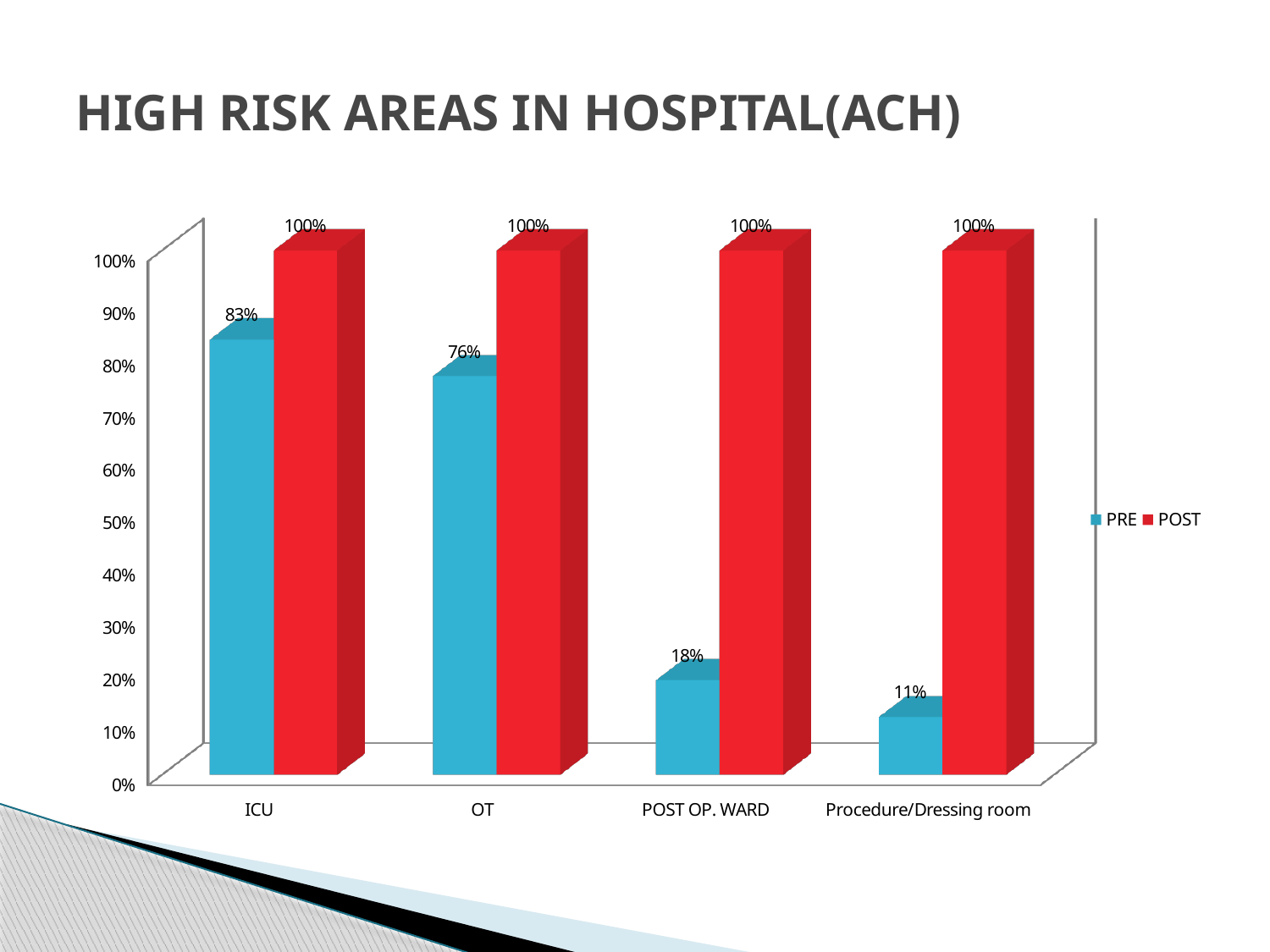
What is the PRE value for Procedure/Dressing room? 11% Which category has the highest PRE value? ICU What is the PRE value for POST OP. WARD? 18% Which category has the lowest PRE value? Procedure/Dressing room What is the PRE value for ICU? 83% How many categories are shown on the x axis? 4 What kind of chart is shown on the slide? Bar chart What is the PRE value for OT? 76% What is the difference between the POST and PRE values for POST OP. WARD? 82% How many series does the legend list? 2 Which is larger, the PRE value for ICU or the PRE value for OT? ICU What is the POST value for OT? 100%